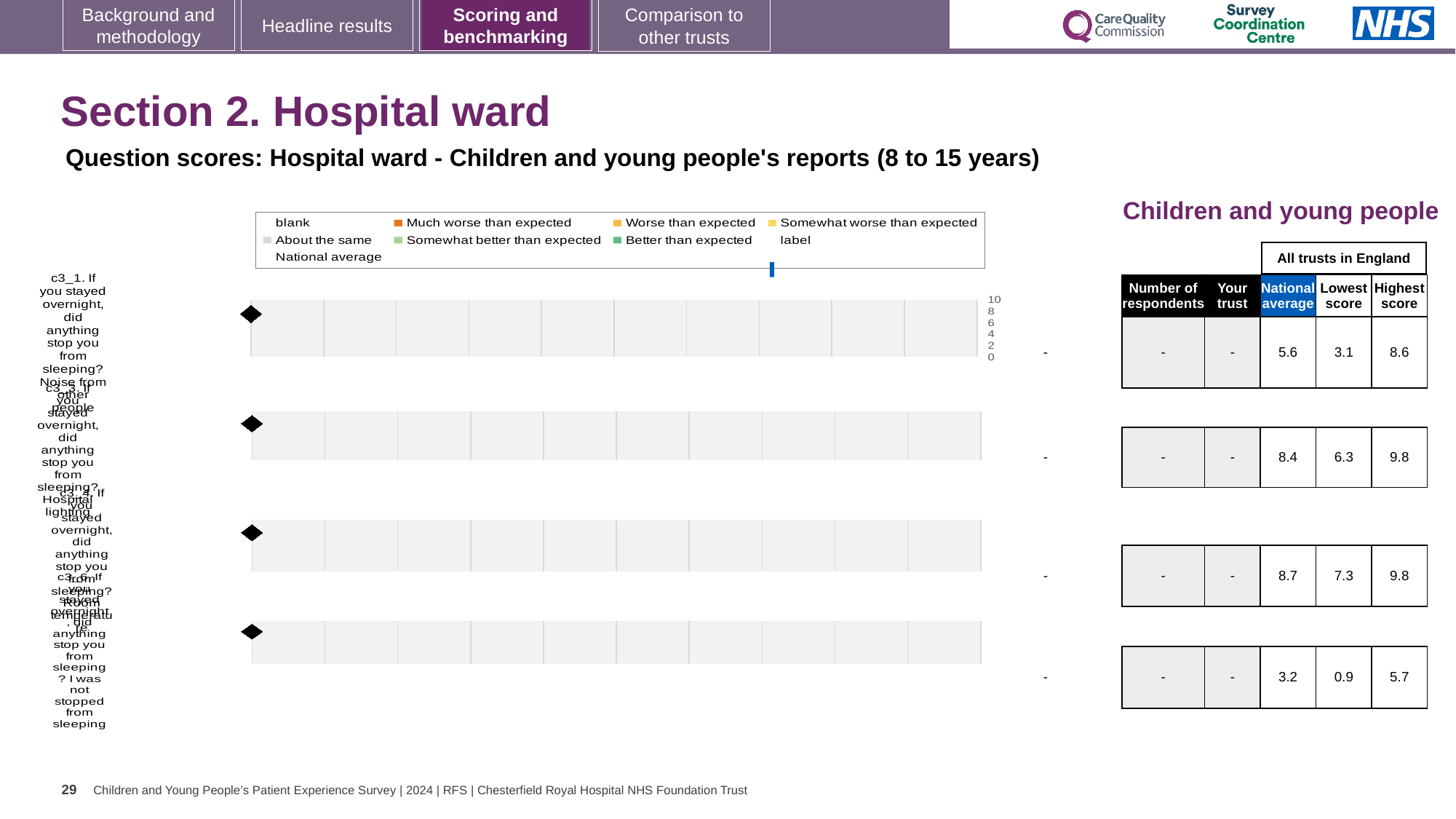
Which question row in the table has the lowest national average? the fourth row (3.2) In the table, what is the national average for the first question row (c3_1, noise from other people)? 5.6 In the table, what is the national average for the third question row? 8.7 Which question row in the table has the highest national average? the third row (8.7) In the table, what is the lowest score for the second question row? 6.3 In the table, what is the difference between the highest score and the lowest score for the first question row? 5.5 In the table, what is the highest score for the fourth question row? 5.7 How many separate chart rows (one per question) are shown on the slide? 4 In the table, is the national average for the second question row larger or smaller than that for the fourth question row? larger What is the highest value shown on the chart's score axis? 10 In the chart legend, what colour is used for 'Much worse than expected'? orange What kind of chart is used on this slide for the question scores? bar chart